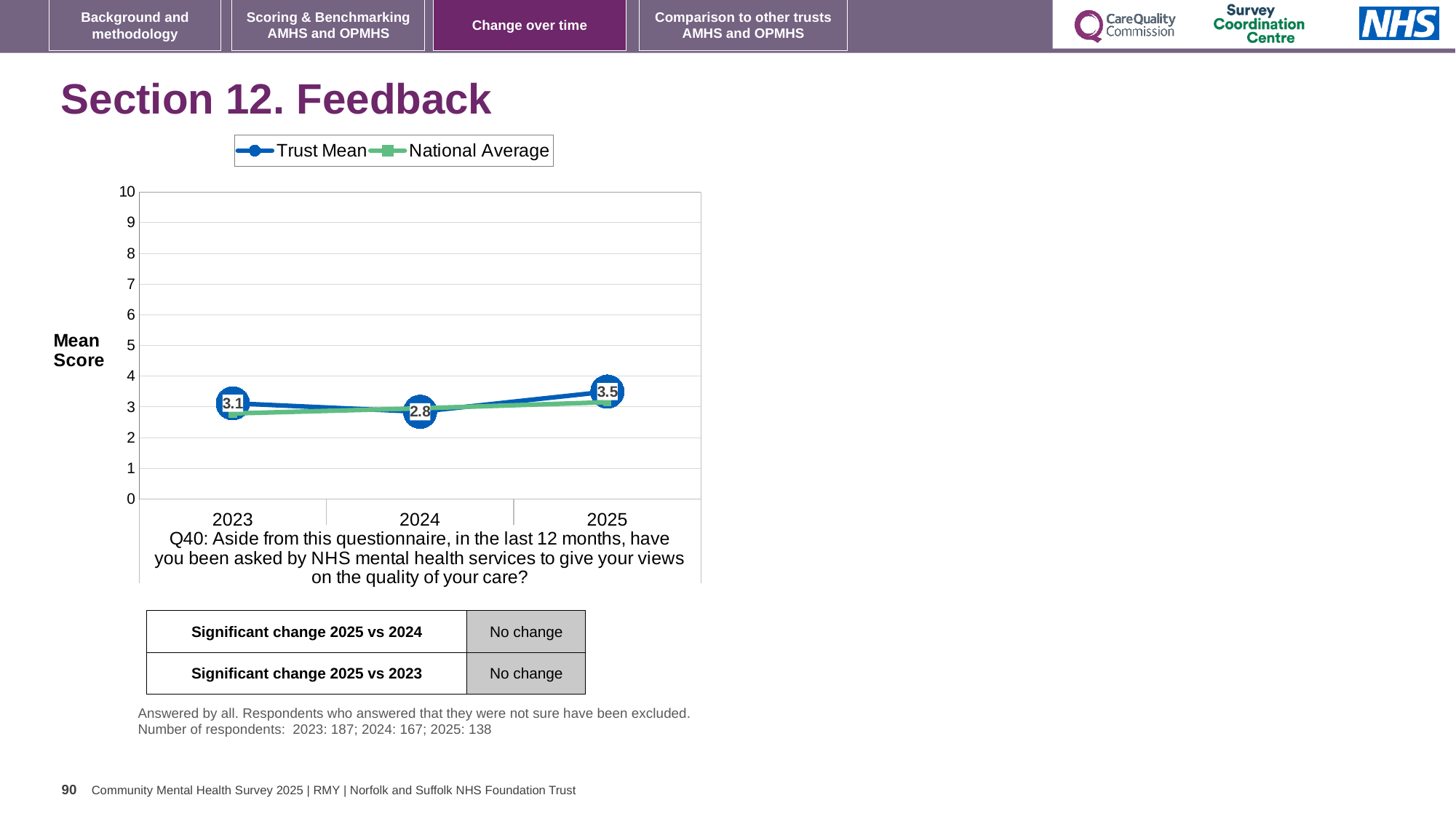
What is the Trust Mean value for 2024? 2.8 How many years are plotted on the x axis? 3 Is the National Average value for 2023 greater or less than 4? less Which is larger, the Trust Mean in 2023 or the Trust Mean in 2025? 2025 In which year is the Trust Mean lowest? 2024 What is the Trust Mean value for 2023? 3.1 Does the Trust Mean rise or fall from 2024 to 2025? rise What is the difference between the Trust Mean in 2025 and in 2024? 0.7 How many series does the legend list? 2 In which year is the Trust Mean highest? 2025 What is the Trust Mean value for 2025? 3.5 What kind of chart is shown on the slide? line chart